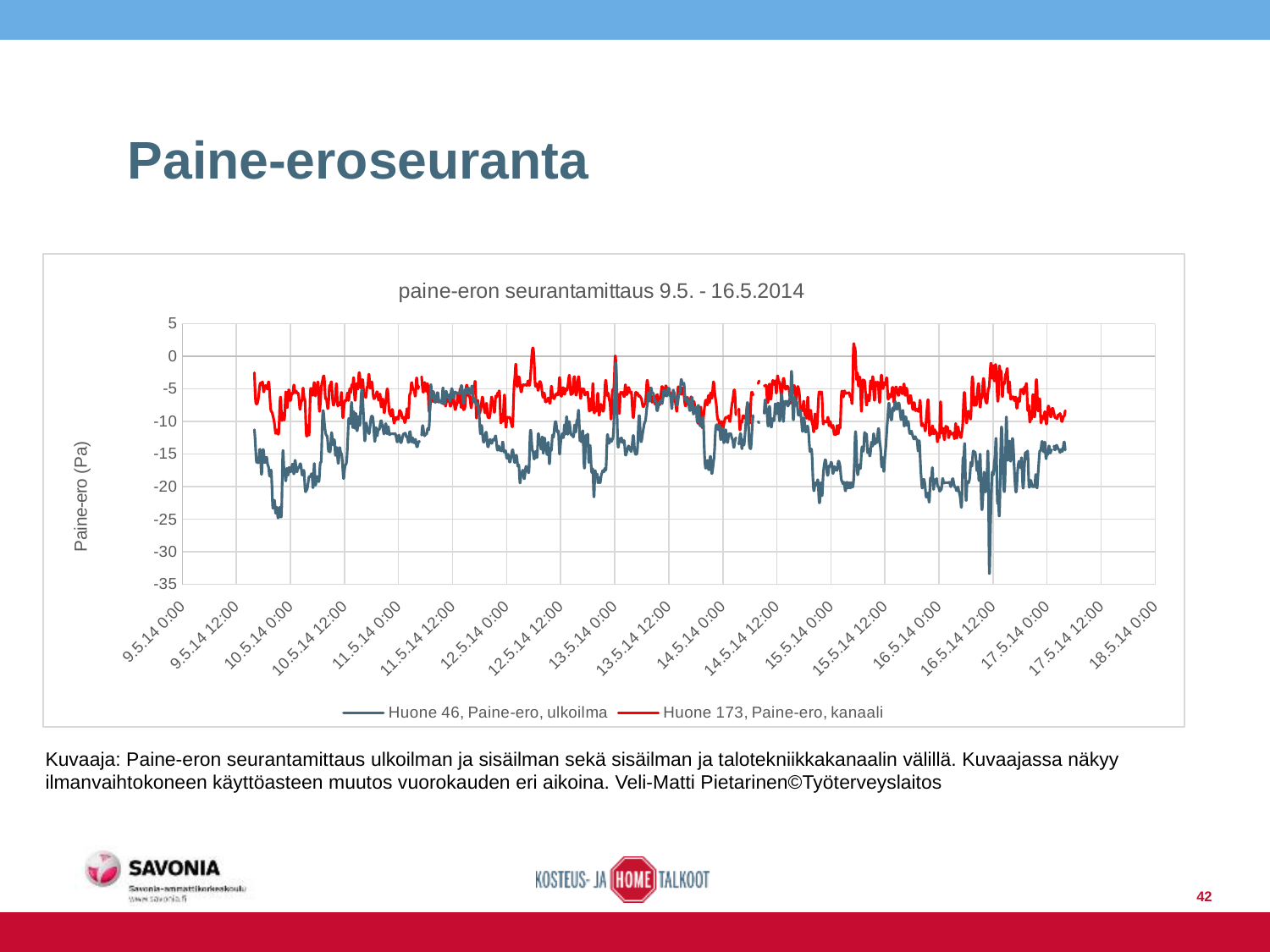
Is the lowest value reached by the Huone 46, Paine-ero, ulkoilma series greater or less than -30? less What is the title of the chart? paine-eron seurantamittaus 9.5. - 16.5.2014 What is the lowest value shown on the vertical axis? -35 Is the lowest value reached by the Huone 173, Paine-ero, kanaali series greater or less than -20? greater Which series is drawn in red? Huone 173, Paine-ero, kanaali Which series generally has the higher (less negative) values, Huone 46, Paine-ero, ulkoilma or Huone 173, Paine-ero, kanaali? Huone 173, Paine-ero, kanaali Is the highest value reached by the Huone 173, Paine-ero, kanaali series greater or less than 0? greater How many series does the chart's legend list? 2 What kind of chart is shown on the slide? line chart